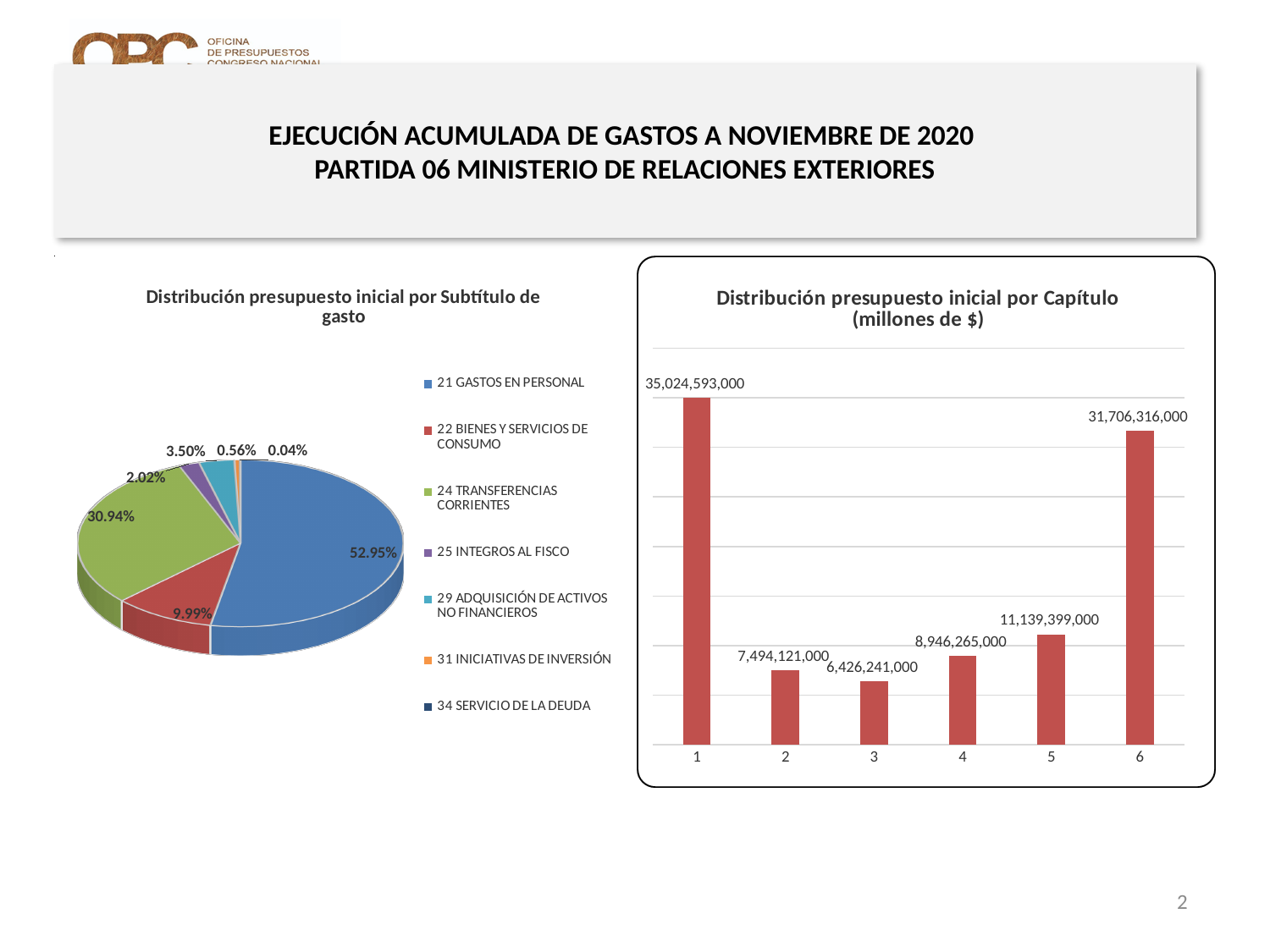
In the chart 'Distribución presupuesto inicial por Capítulo (millones de $)', what is the difference between the values for category 1 and category 6? 3,318,277,000 In the pie chart 'Distribución presupuesto inicial por Subtítulo de gasto', which subtítulo has the smallest share? 34 SERVICIO DE LA DEUDA In the chart 'Distribución presupuesto inicial por Capítulo (millones de $)', what is the value for category 5? 11,139,399,000 In the chart 'Distribución presupuesto inicial por Capítulo (millones de $)', which category has the highest value? 1 In the chart 'Distribución presupuesto inicial por Capítulo (millones de $)', which is larger, the value for category 2 or category 4? Category 4 In the chart 'Distribución presupuesto inicial por Capítulo (millones de $)', which category has the lowest value? 3 What kind of chart is 'Distribución presupuesto inicial por Capítulo (millones de $)'? Bar chart In the chart 'Distribución presupuesto inicial por Capítulo (millones de $)', how many categories are shown on the x axis? 6 In the chart 'Distribución presupuesto inicial por Capítulo (millones de $)', what is the value for category 1? 35,024,593,000 In the pie chart 'Distribución presupuesto inicial por Subtítulo de gasto', what share does 21 GASTOS EN PERSONAL have? 52.95% How many entries does the legend of the pie chart 'Distribución presupuesto inicial por Subtítulo de gasto' list? 7 In the pie chart 'Distribución presupuesto inicial por Subtítulo de gasto', what share does 24 TRANSFERENCIAS CORRIENTES have? 30.94%